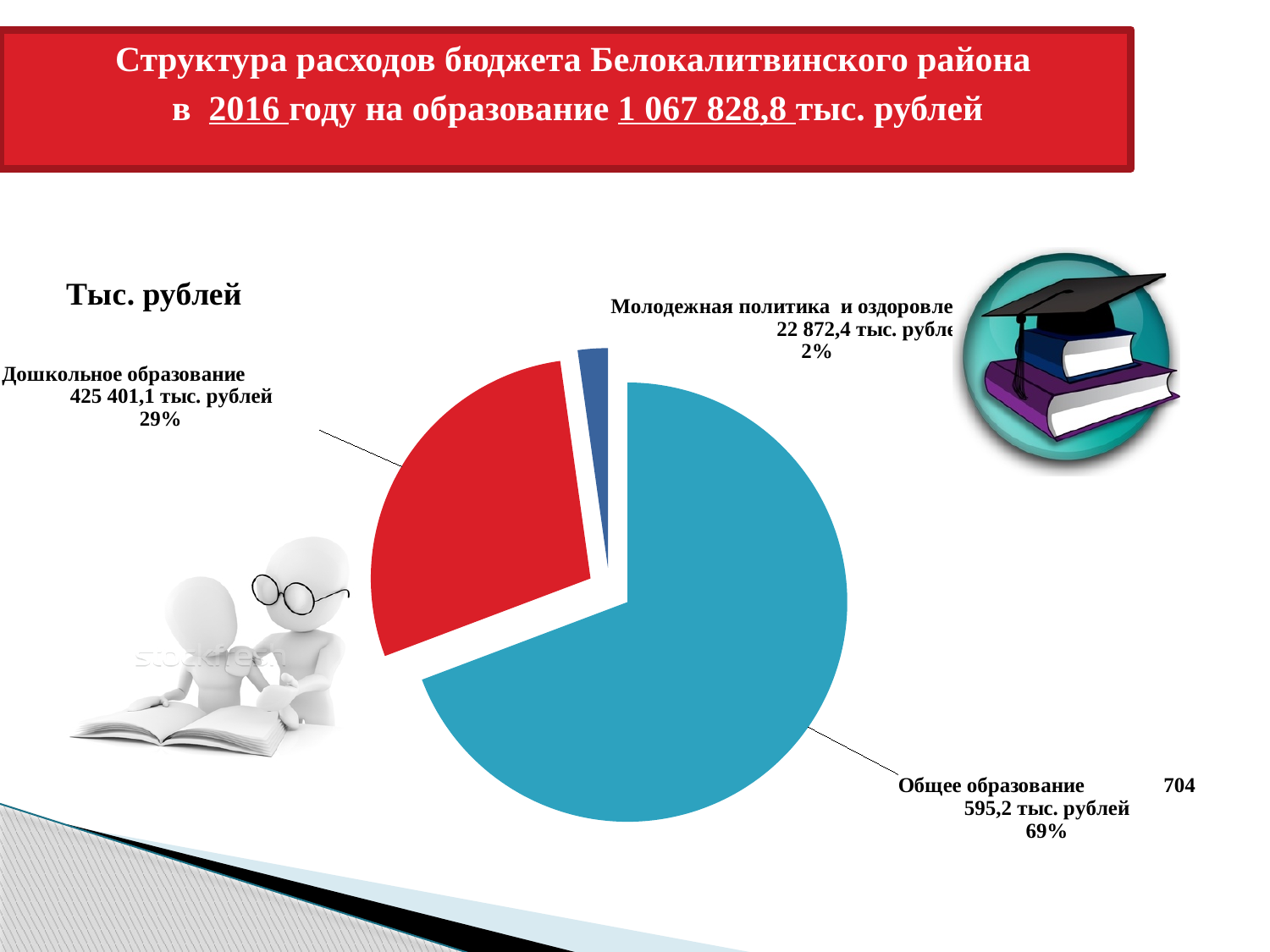
What is the value shown for Общее образование? 704 595,2 тыс. рублей Which category has the largest slice of the pie? Общее образование How many slices does the pie chart have? 3 What kind of chart is shown on the slide? Pie chart What is the value shown for Молодежная политика и оздоровление? 22 872,4 тыс. рублей What share of the pie does Молодежная политика и оздоровление take? 2% According to the slide title, what is the total education expenditure of the Белокалитвинский район budget in 2016? 1 067 828,8 тыс. рублей Which category has the smallest slice of the pie? Молодежная политика и оздоровление What share of the pie does Общее образование take? 69% What share of the pie does Дошкольное образование take? 29% What is the difference between the values for Общее образование and Дошкольное образование? 279 194,1 тыс. рублей What is the value shown for Дошкольное образование? 425 401,1 тыс. рублей